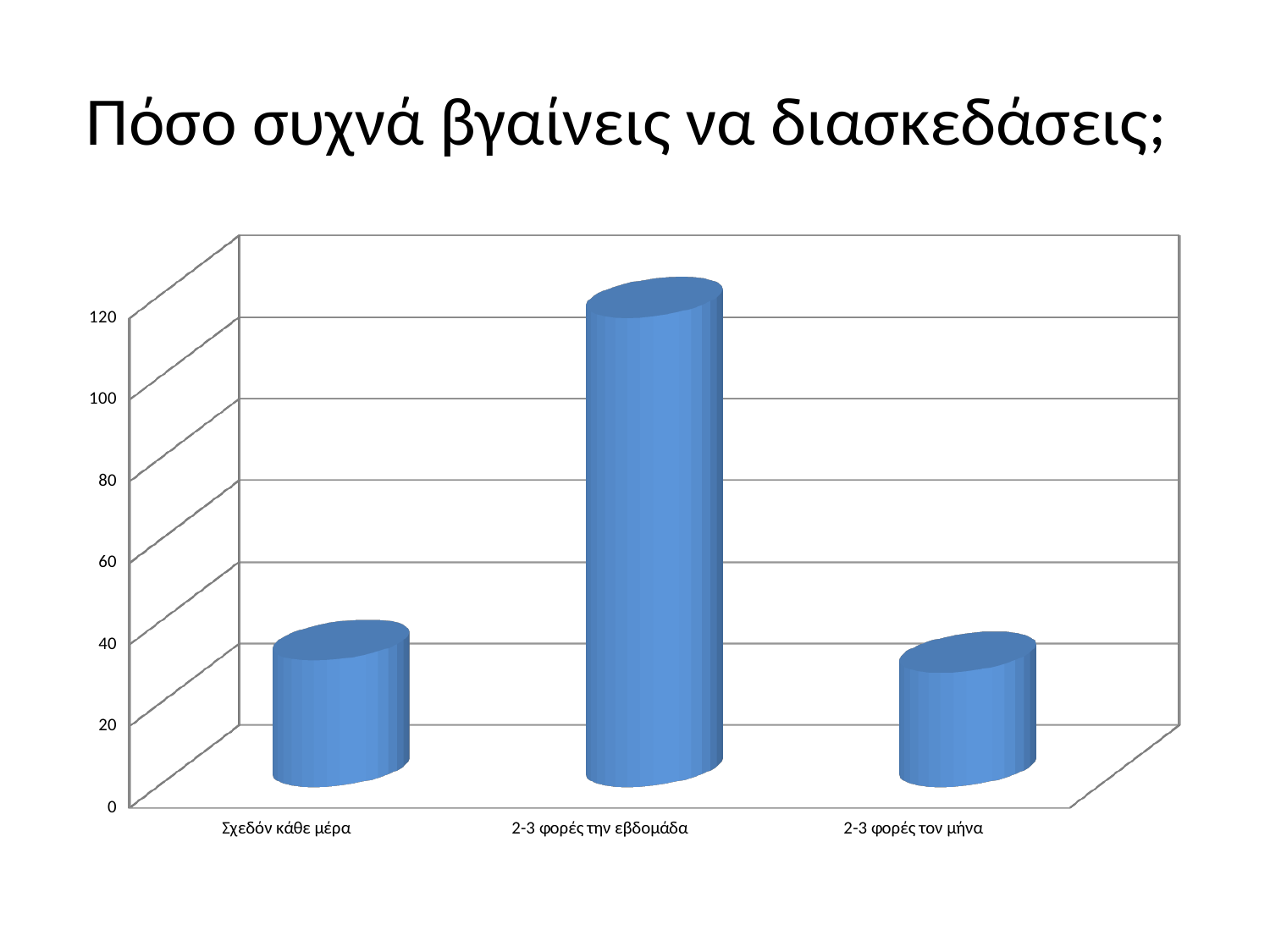
How many categories are shown on the x axis of the chart? 3 Is the value for "2-3 φορές τον μήνα" greater or less than 60? less Which category has the highest value in the chart? 2-3 φορές την εβδομάδα Is the value for "Σχεδόν κάθε μέρα" greater or less than 60? less What is the title of the slide containing the chart? Πόσο συχνά βγαίνεις να διασκεδάσεις; Which is larger, the value for "2-3 φορές την εβδομάδα" or the value for "2-3 φορές τον μήνα"? 2-3 φορές την εβδομάδα What is the highest value labelled on the vertical axis of the chart? 120 Is the value for "2-3 φορές την εβδομάδα" greater or less than 100? greater What kind of chart is shown on the slide? Bar chart Which is larger, the value for "2-3 φορές την εβδομάδα" or the value for "Σχεδόν κάθε μέρα"? 2-3 φορές την εβδομάδα